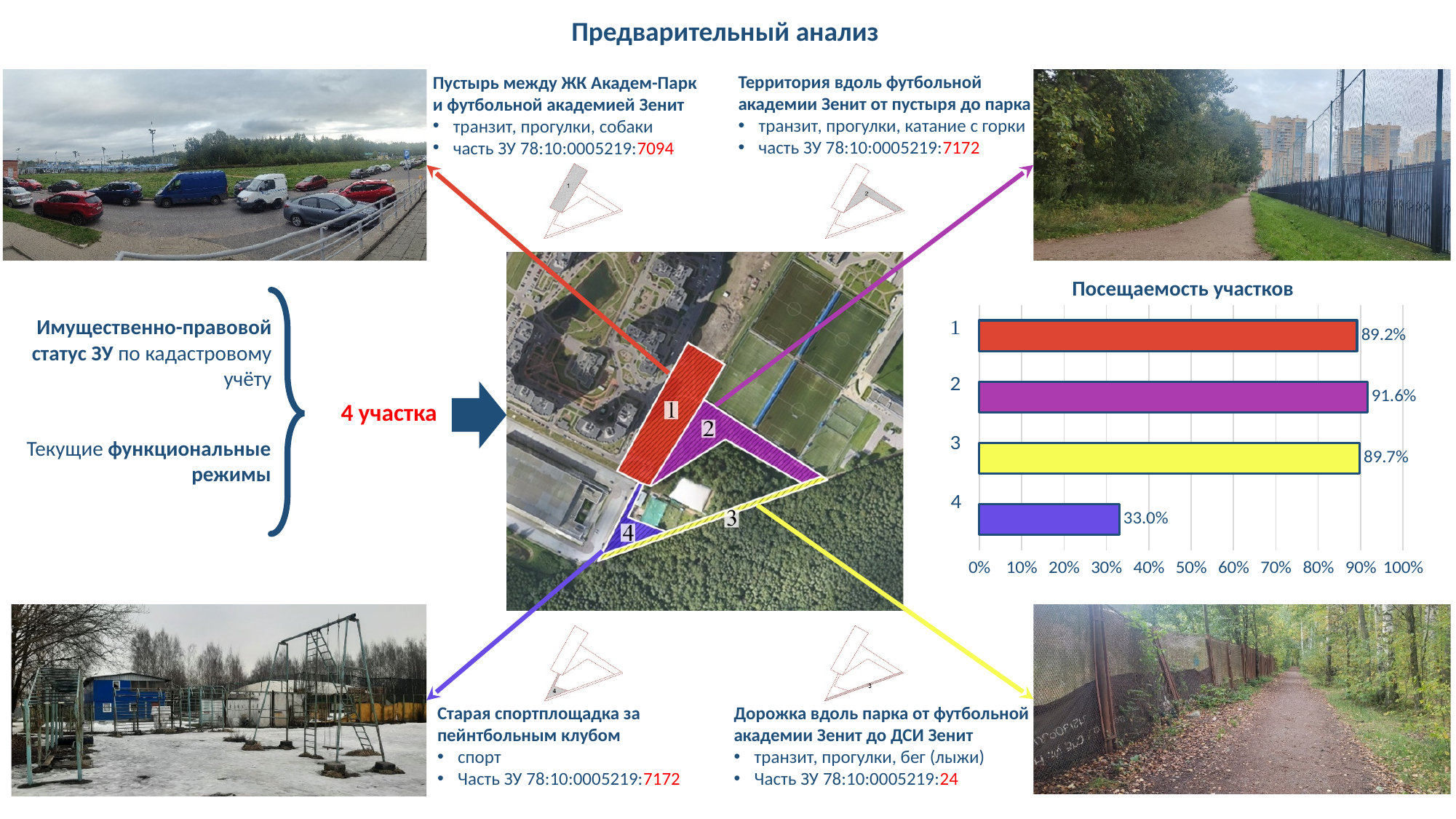
Which участок has the highest value in the chart? 2 What is the value for участок 4 in the chart? 33.0% What colour is the bar for участок 3 in the chart? yellow What type of chart is shown on the slide? bar chart Which участок has the lowest value in the chart? 4 Which is larger: the value for участок 1 or участок 4? участок 1 What is the value for участок 3 in the chart? 89.7% What is the value for участок 1 in the chart? 89.2% What is the title of the chart on the slide? Посещаемость участков What is the difference between the values for участок 2 and участок 4? 58.6% What is the value for участок 2 in the chart? 91.6% How many categories are plotted in the chart? 4